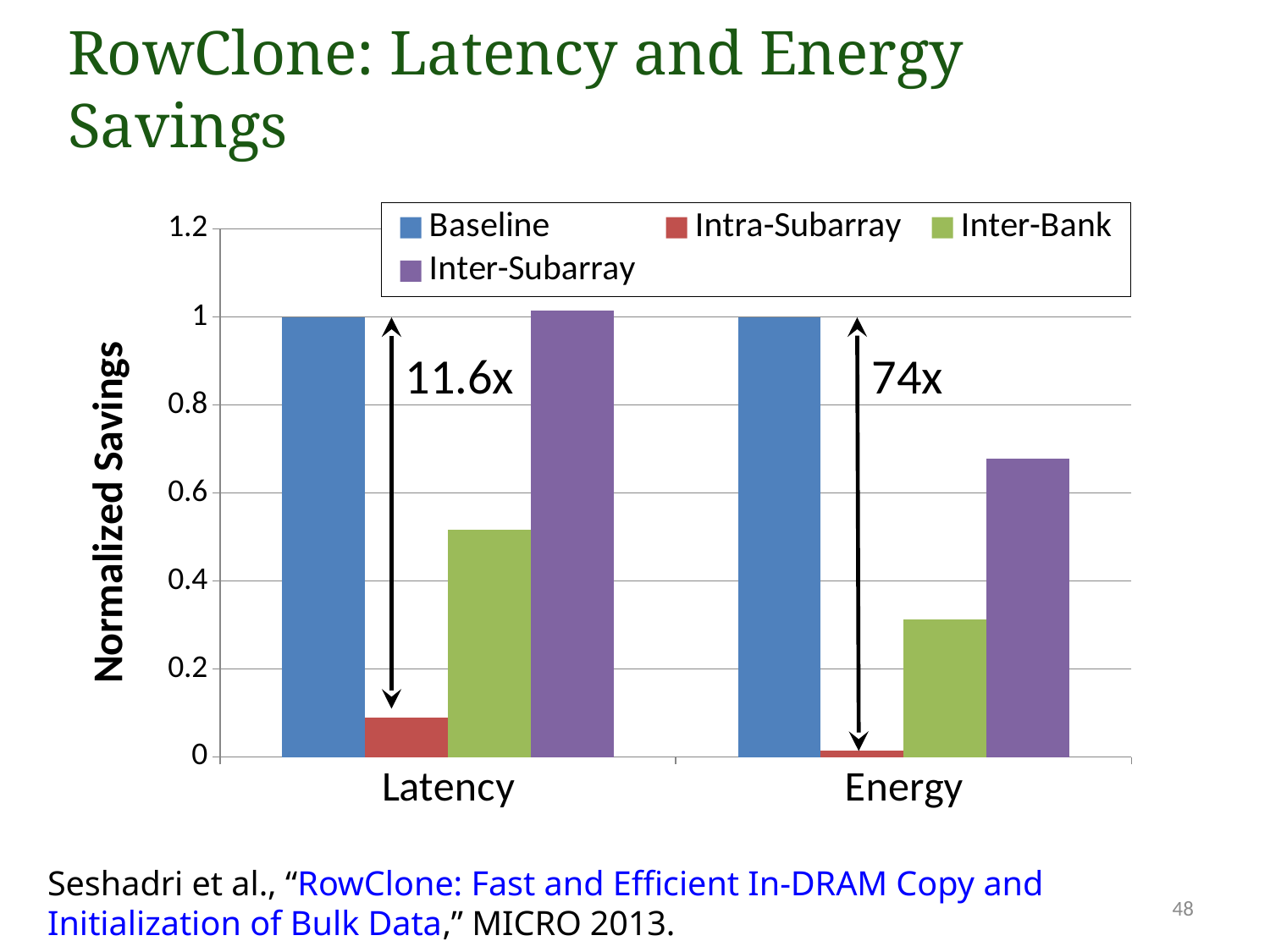
Which series has the highest value for Energy? Baseline What is the Baseline value for Latency? 1 What kind of chart is shown on the slide? bar chart What improvement factor is annotated for Energy between Baseline and Intra-Subarray? 74x How many series does the legend list? 4 Is the Inter-Bank value for Latency greater or less than 0.4? greater What is the Baseline value for Energy? 1 Is the Inter-Subarray value for Energy greater or less than 0.6? greater Is the Intra-Subarray value for Latency greater or less than 0.2? less Which is larger, the Inter-Bank value for Latency or the Inter-Bank value for Energy? Latency Which series has the lowest value for Energy? Intra-Subarray How many categories are shown on the x axis? 2